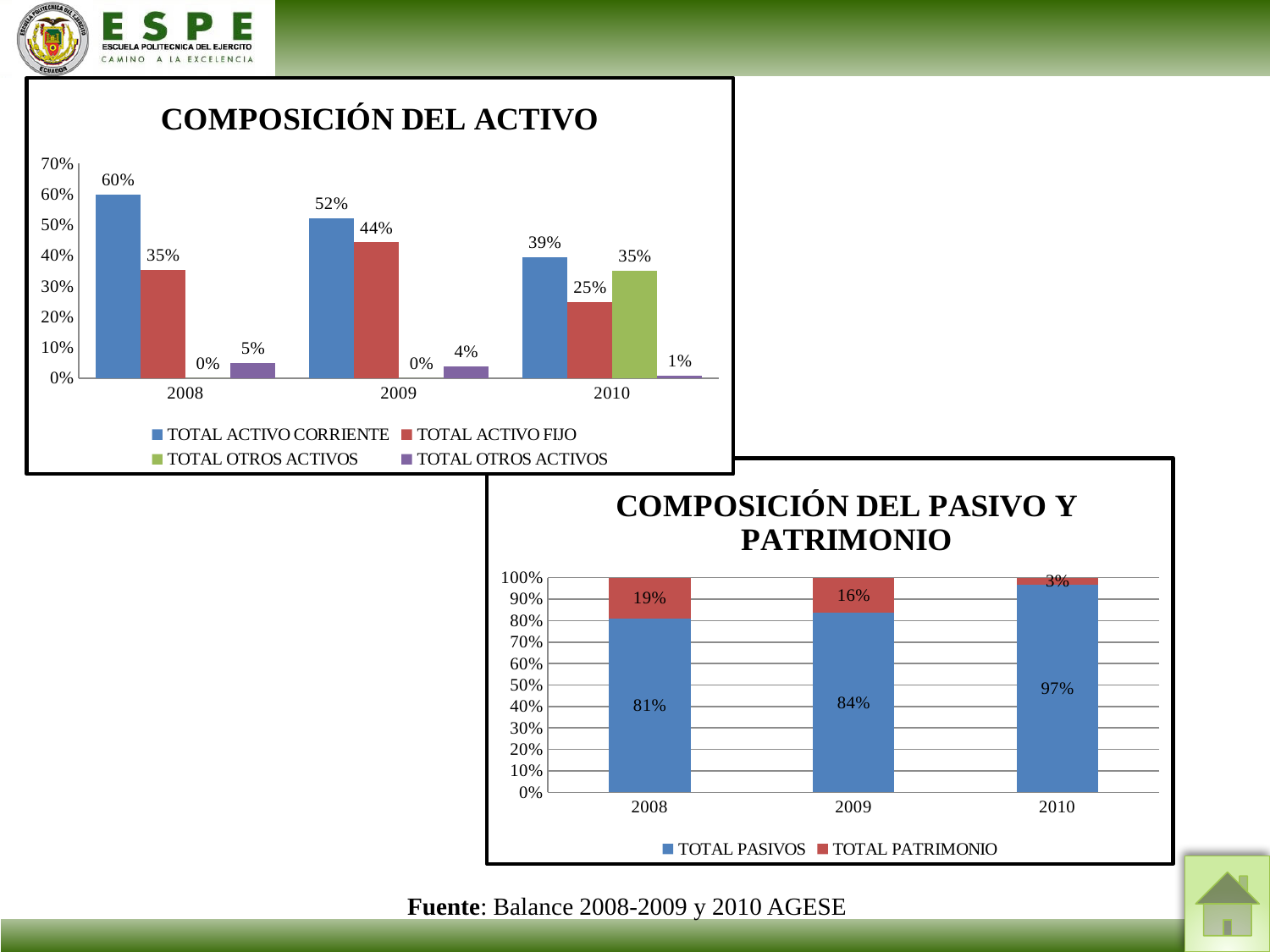
In the 'COMPOSICIÓN DEL ACTIVO' chart, what is the value of TOTAL ACTIVO CORRIENTE in 2008? 60% In the 'COMPOSICIÓN DEL PASIVO Y PATRIMONIO' chart, what is the total of the stacked bar for 2008? 100% In the 'COMPOSICIÓN DEL ACTIVO' chart, what is the value of TOTAL ACTIVO FIJO in 2009? 44% In the 'COMPOSICIÓN DEL ACTIVO' chart, how many entries does the legend list? 4 In the 'COMPOSICIÓN DEL ACTIVO' chart, which is larger in 2010: TOTAL ACTIVO CORRIENTE or TOTAL ACTIVO FIJO? TOTAL ACTIVO CORRIENTE In the 'COMPOSICIÓN DEL PASIVO Y PATRIMONIO' chart, in which year is TOTAL PATRIMONIO highest? 2008 In the 'COMPOSICIÓN DEL ACTIVO' chart, what is the difference between TOTAL ACTIVO CORRIENTE and TOTAL ACTIVO FIJO in 2008? 25% In the 'COMPOSICIÓN DEL PASIVO Y PATRIMONIO' chart, what is the value of TOTAL PASIVOS in 2009? 84% In the 'COMPOSICIÓN DEL ACTIVO' chart, does TOTAL ACTIVO CORRIENTE rise or fall from 2008 to 2010? fall In the 'COMPOSICIÓN DEL ACTIVO' chart, in which year is TOTAL ACTIVO CORRIENTE lowest? 2010 In the 'COMPOSICIÓN DEL PASIVO Y PATRIMONIO' chart, what is the value of TOTAL PATRIMONIO in 2010? 3% What kind of chart is 'COMPOSICIÓN DEL PASIVO Y PATRIMONIO'? stacked bar chart